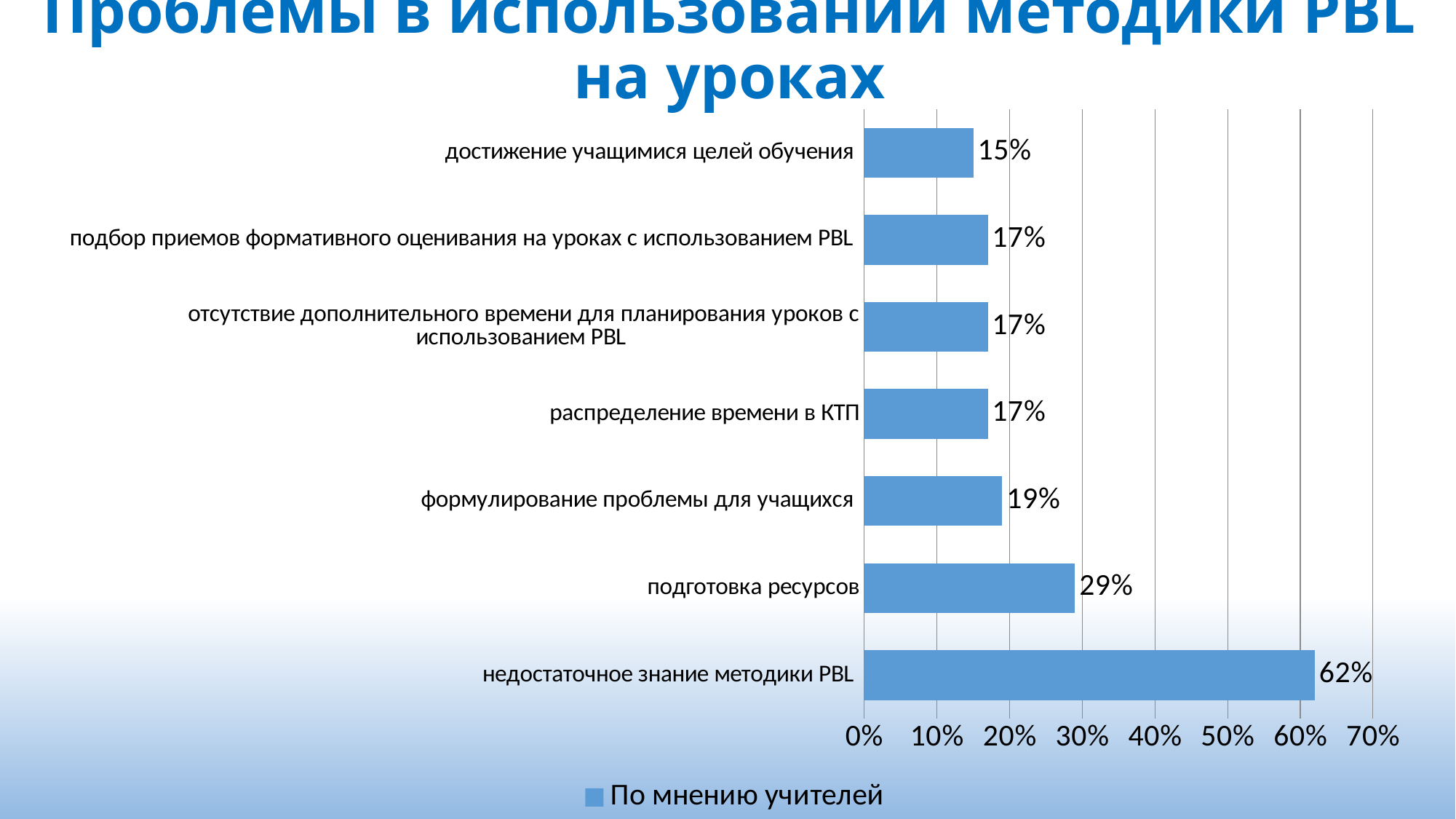
What series name does the legend show? По мнению учителей Which category has the lowest value? достижение учащимися целей обучения Is the value for 'недостаточное знание методики PBL' greater or less than 50%? greater Which is larger: the value for 'подготовка ресурсов' or the value for 'формулирование проблемы для учащихся'? подготовка ресурсов What is the value for 'формулирование проблемы для учащихся'? 19% What kind of chart is shown on the slide? bar chart What is the value for 'подготовка ресурсов'? 29% What is the value for 'недостаточное знание методики PBL'? 62% What is the value for 'достижение учащимися целей обучения'? 15% How many categories are shown in the chart? 7 Which category has the highest value? недостаточное знание методики PBL What is the difference between the values for 'недостаточное знание методики PBL' and 'подготовка ресурсов'? 33%